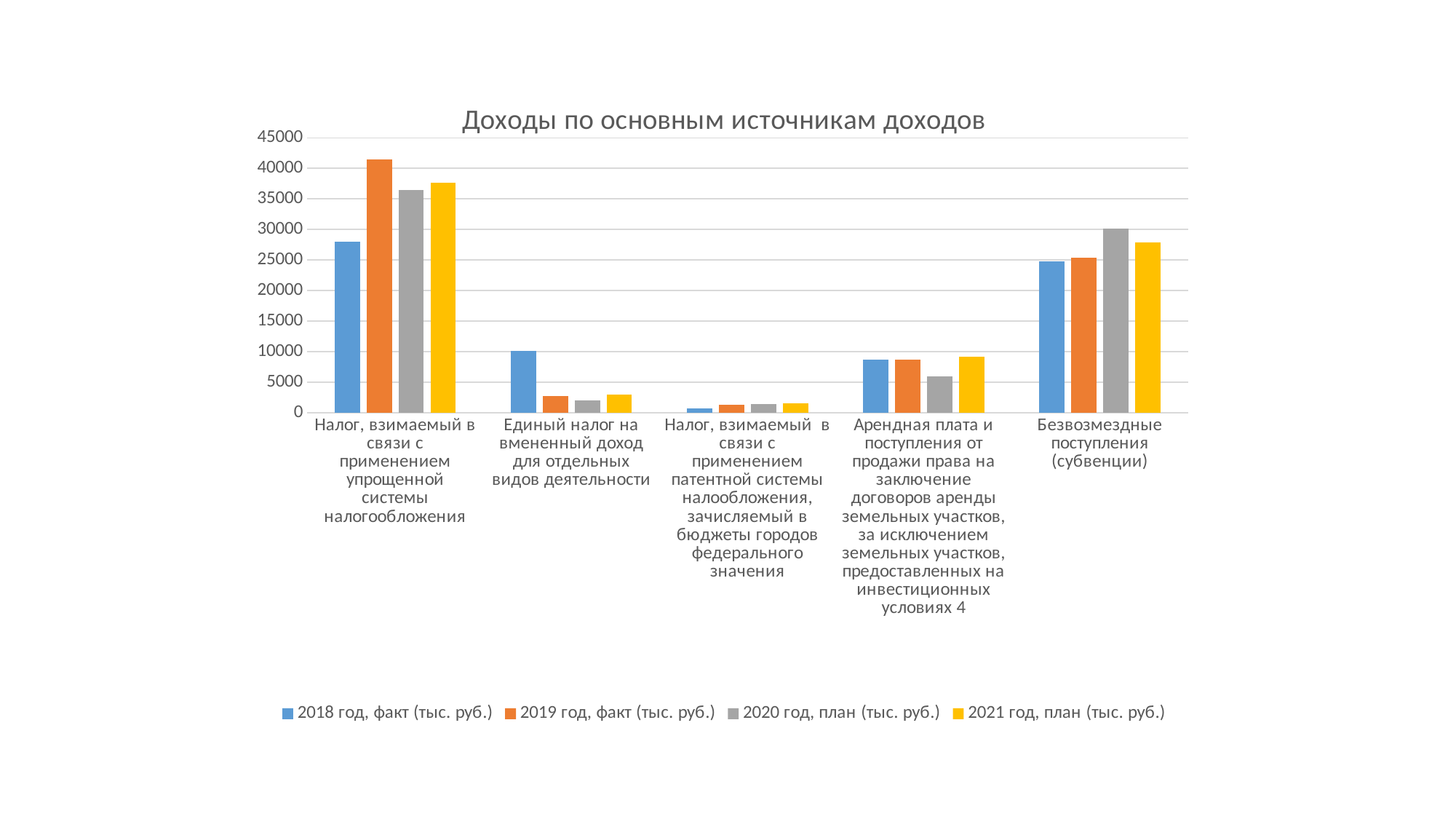
For Безвозмездные поступления (субвенции), which is larger: the 2018 год, факт value or the 2020 год, план value? 2020 год, план (тыс. руб.) Is the 2018 год, факт value for Единый налог на вмененный доход для отдельных видов деятельности greater or less than 5000? greater Which category has the highest value for the series 2019 год, факт (тыс. руб.)? Налог, взимаемый в связи с применением упрощенной системы налогообложения Which category has the lowest value for the series 2018 год, факт (тыс. руб.)? Налог, взимаемый в связи с применением патентной системы налообложения, зачисляемый в бюджеты городов федерального значения For Единый налог на вмененный доход для отдельных видов деятельности, which is larger: the 2018 год, факт value or the 2019 год, факт value? 2018 год, факт (тыс. руб.) What kind of chart is shown on the slide? Bar chart How many series does the legend list? 4 How many categories are shown on the x axis? 5 Is the 2020 год, план value for Безвозмездные поступления (субвенции) greater or less than 25000? greater Is the 2019 год, факт value for Налог, взимаемый в связи с применением упрощенной системы налогообложения greater or less than 40000? greater For Безвозмездные поступления (субвенции), do the values rise or fall from 2018 год, факт to 2020 год, план? rise What is the title of the chart? Доходы по основным источникам доходов